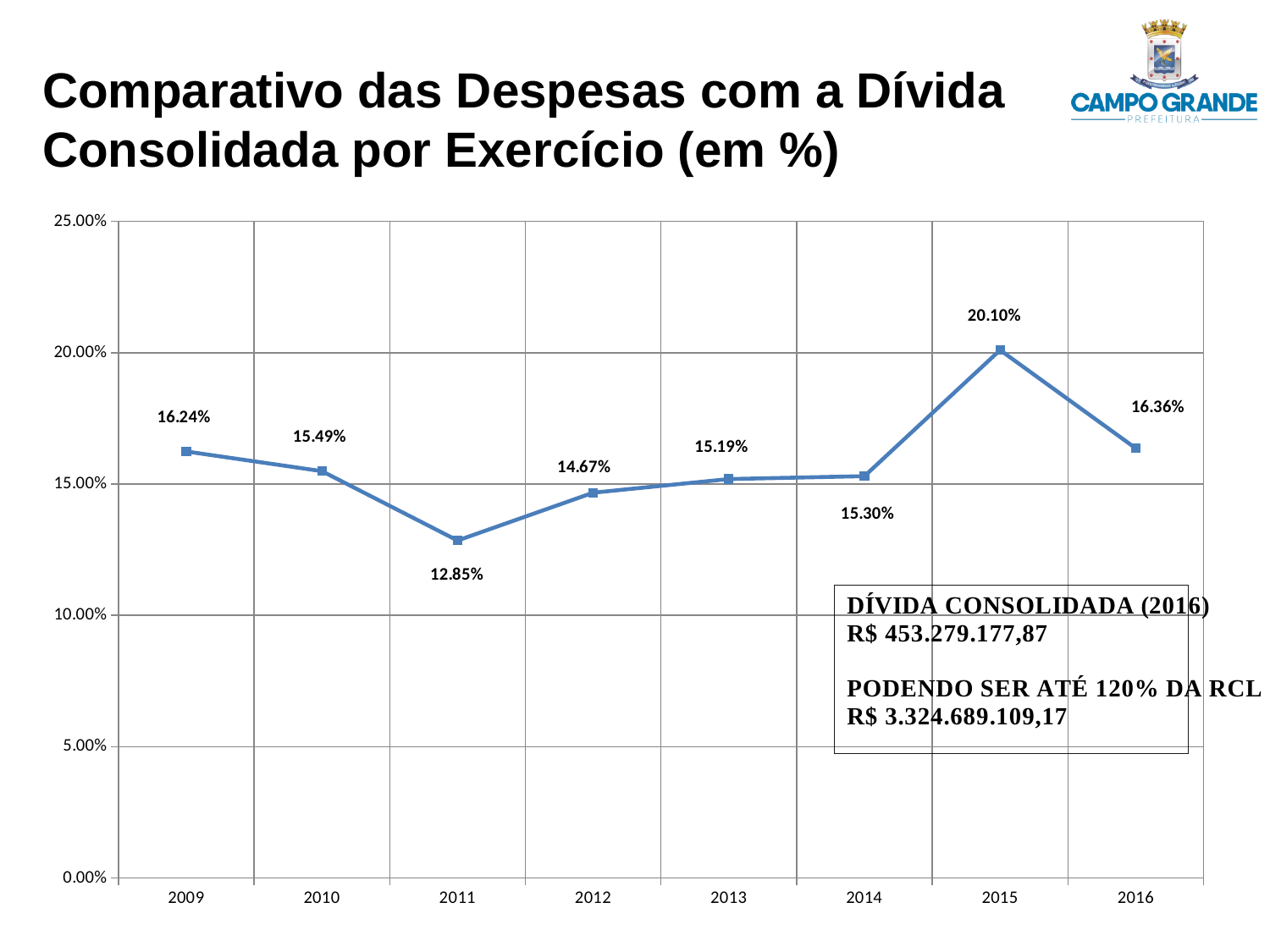
What is the difference between the values for 2015 and 2016? 3.74% How many years are plotted on the x axis? 8 Which year has the highest value? 2015 Which year has the lowest value? 2011 What is the value for 2009? 16.24% What is the difference between the values for 2009 and 2011? 3.39% What is the value for 2015? 20.10% What is the value for 2011? 12.85% Does the value rise or fall from 2015 to 2016? fall What kind of chart is shown on the slide? line chart Which is larger, the value for 2010 or the value for 2012? 2010 Is the value for 2015 greater or less than 20.00%? greater